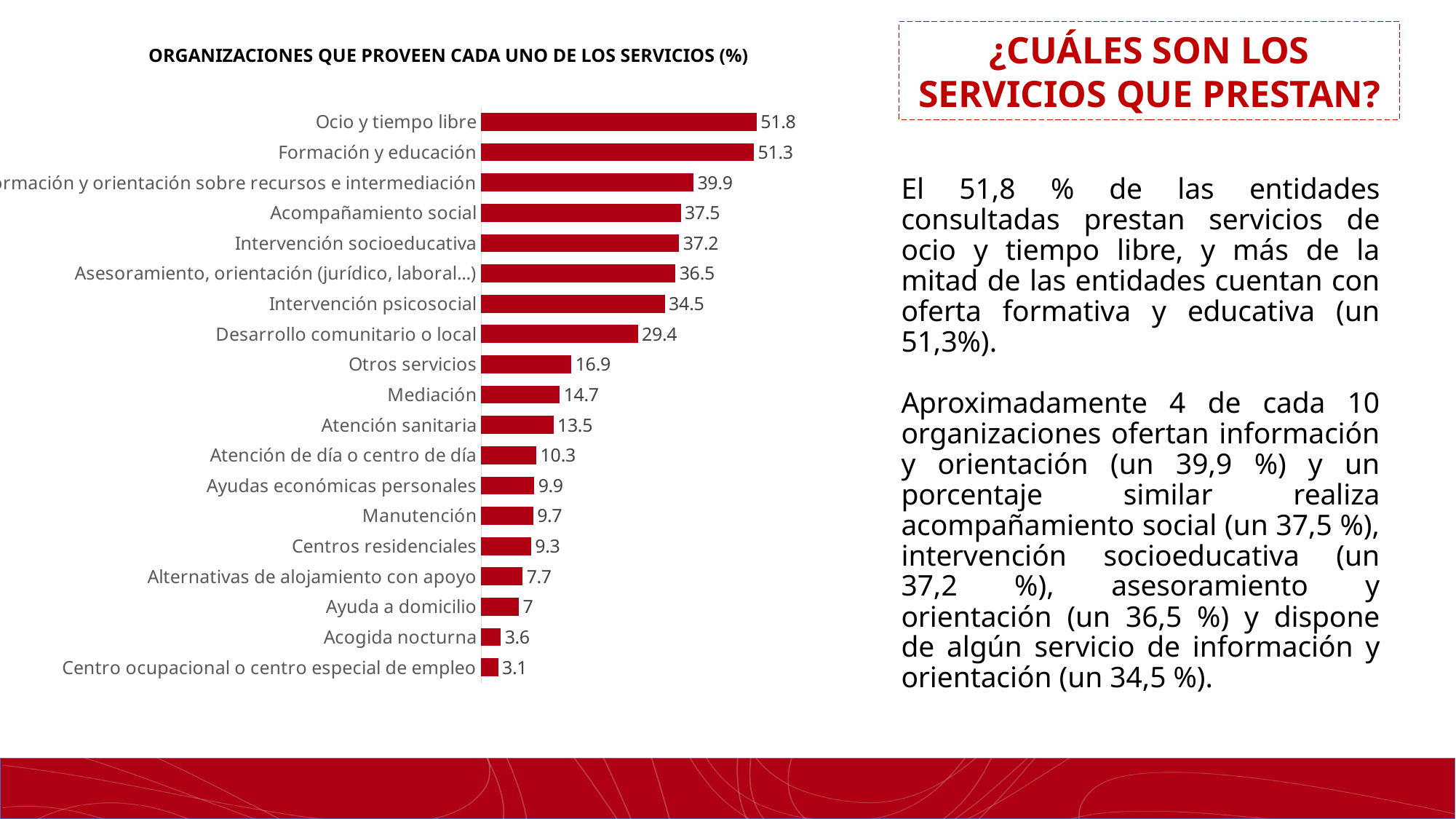
How many categories are shown in the chart? 19 What type of chart is shown on the slide? Bar chart What is the value for Acogida nocturna? 3.6 What is the title of the chart? ORGANIZACIONES QUE PROVEEN CADA UNO DE LOS SERVICIOS (%) What is the value for Ocio y tiempo libre? 51.8 Which category has the highest value? Ocio y tiempo libre What is the value for Intervención psicosocial? 34.5 Which category has the lowest value? Centro ocupacional o centro especial de empleo What is the difference between the values for Ocio y tiempo libre and Centro ocupacional o centro especial de empleo? 48.7 Which is larger, the value for Acompañamiento social or the value for Intervención socioeducativa? Acompañamiento social What is the value for Mediación? 14.7 What is the difference between the values for Otros servicios and Mediación? 2.2